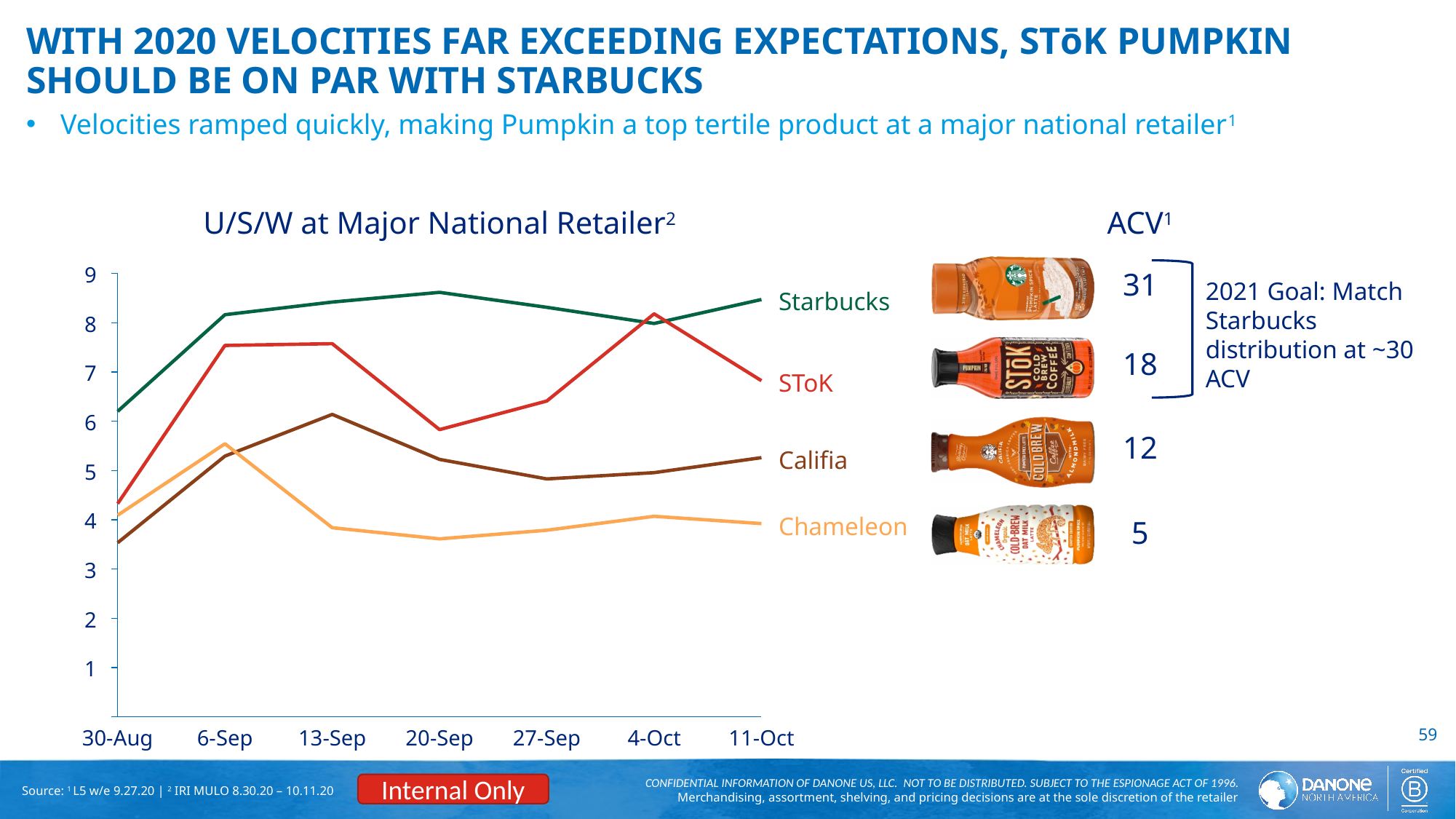
How many dates are shown on the x axis of the "U/S/W at Major National Retailer" chart? 7 On the "U/S/W at Major National Retailer" chart, which is larger at 13-Sep: SToK or Califia? SToK What is the ACV value shown for SToK? 18 On the "U/S/W at Major National Retailer" chart, is the value for SToK at 30-Aug greater or less than 5? less On the "U/S/W at Major National Retailer" chart, which series has the highest value at 11-Oct? Starbucks On the "U/S/W at Major National Retailer" chart, is the value for Starbucks at 20-Sep greater or less than 8? greater On the "U/S/W at Major National Retailer" chart, does the Starbucks line rise or fall from 30-Aug to 6-Sep? rise How many series are plotted on the "U/S/W at Major National Retailer" chart? 4 What is the ACV value shown for Starbucks? 31 On the "U/S/W at Major National Retailer" chart, is the value for Chameleon at 20-Sep greater or less than 4? less What kind of chart is the "U/S/W at Major National Retailer" chart? line chart On the "U/S/W at Major National Retailer" chart, which series has the lowest value at 11-Oct? Chameleon